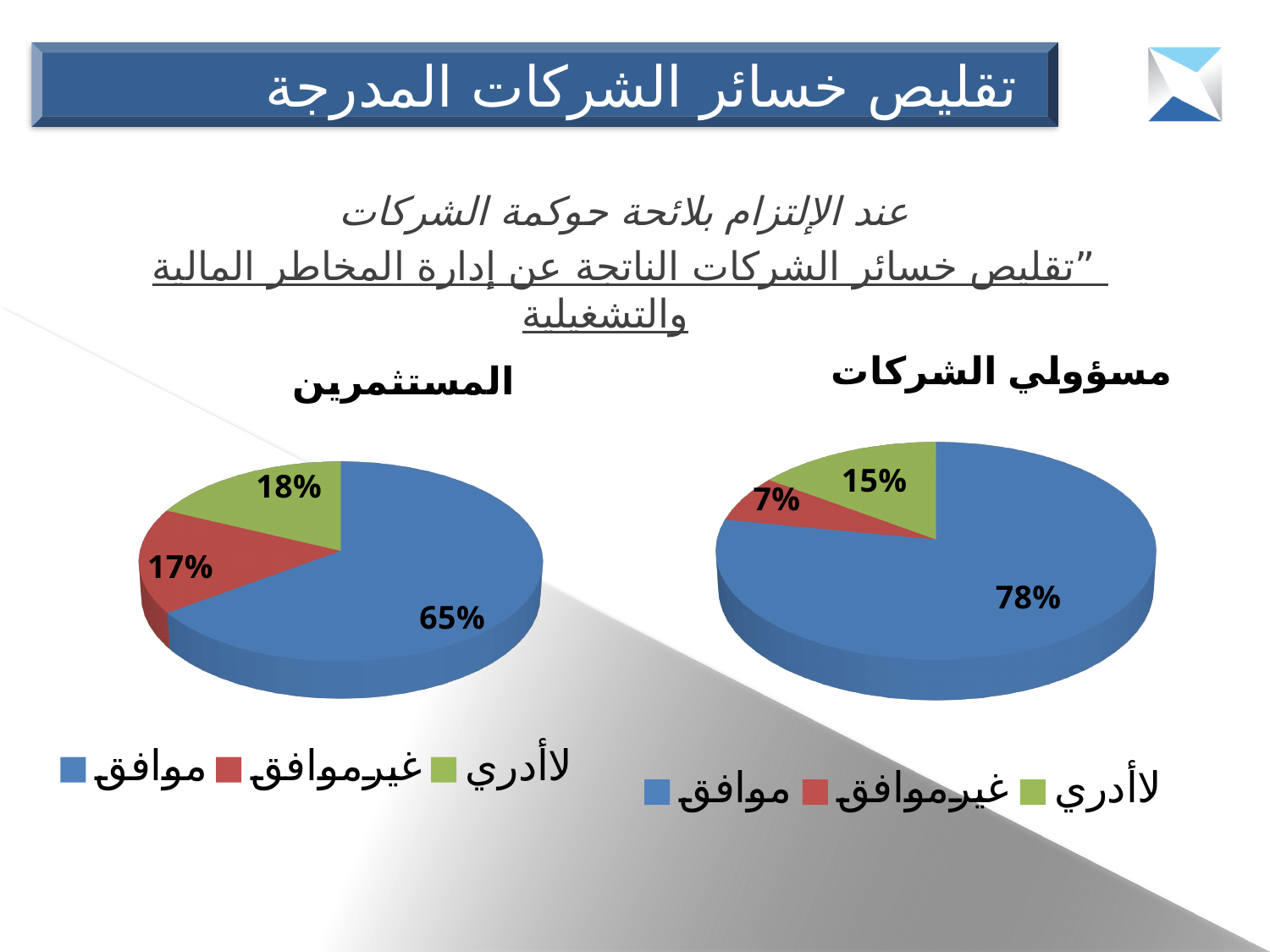
How many entries does the legend of the "المستثمرين" chart list? 3 In the "المستثمرين" pie chart, what percentage is shown for "غير موافق"? 17% In the "مسؤولي الشركات" pie chart, what percentage is shown for "لا أدري"? 15% How many slices does the "المستثمرين" pie chart have? 3 What type of chart is used for "مسؤولي الشركات"? Pie chart In the "مسؤولي الشركات" pie chart, what colour is the "لا أدري" slice? Green In the "مسؤولي الشركات" pie chart, which category has the smallest slice? غير موافق In the "مسؤولي الشركات" pie chart, what percentage is shown for "موافق"? 78% In the "المستثمرين" pie chart, which category has the largest slice? موافق What is the difference between the "موافق" share in the "مسؤولي الشركات" chart and the "موافق" share in the "المستثمرين" chart? 13% In the "المستثمرين" pie chart, what percentage is shown for "موافق"? 65% Which is larger: the "غير موافق" share in the "المستثمرين" chart or the "غير موافق" share in the "مسؤولي الشركات" chart? المستثمرين